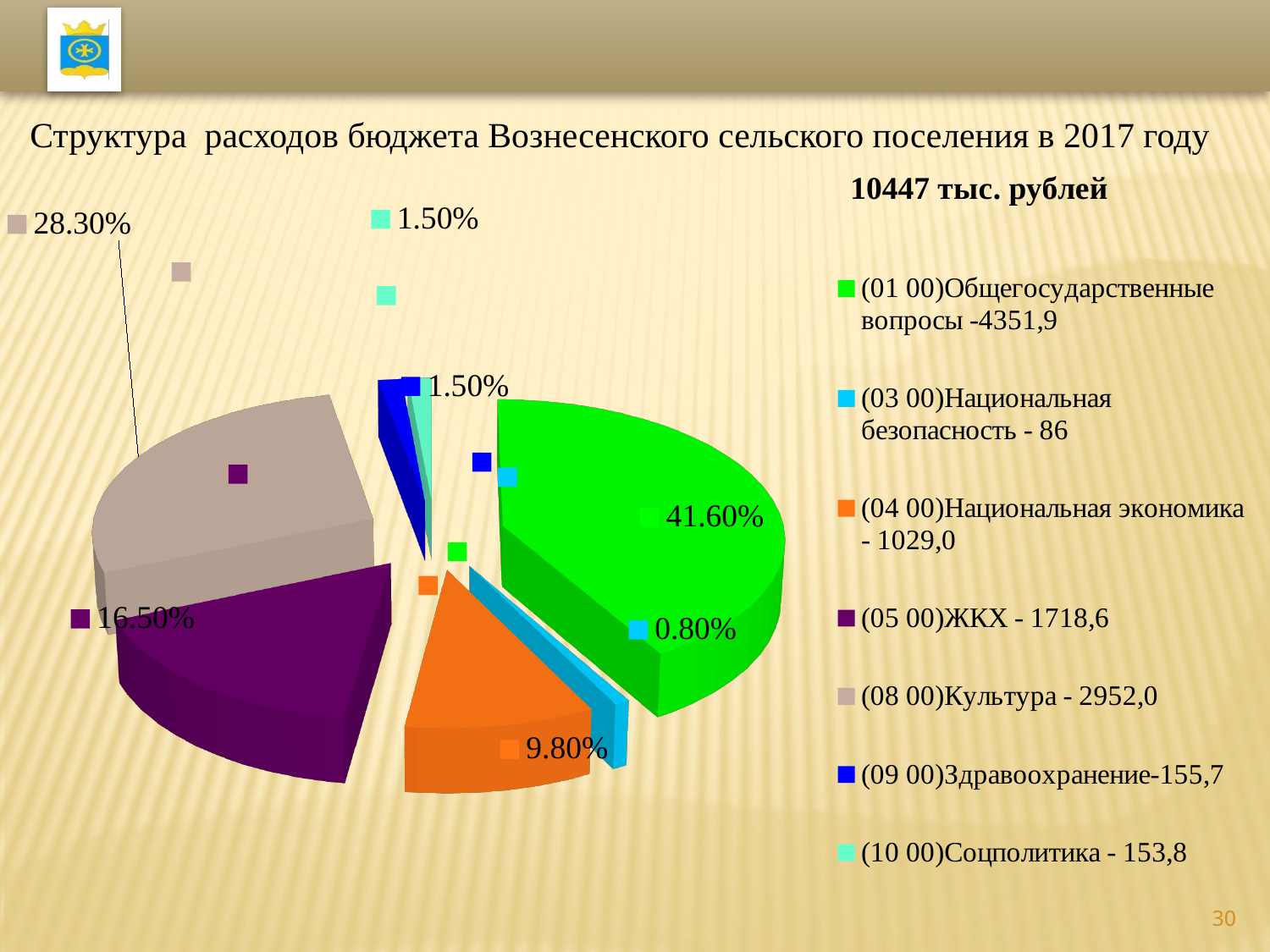
What total budget amount is stated above the legend? 10447 тыс. рублей What kind of chart is shown on the slide? pie chart What share of the pie does (08 00)Культура have? 28.30% What share of the pie does (01 00)Общегосударственные вопросы have? 41.60% How many categories does the legend of the pie chart list? 7 What is the difference between the shares of (01 00)Общегосударственные вопросы and (08 00)Культура? 13.30% Which category has the largest slice of the pie? (01 00)Общегосударственные вопросы What share of the pie does (04 00)Национальная экономика have? 9.80% Which category has the smallest slice of the pie? (03 00)Национальная безопасность Which is larger: the share for (08 00)Культура or the share for (05 00)ЖКХ? (08 00)Культура